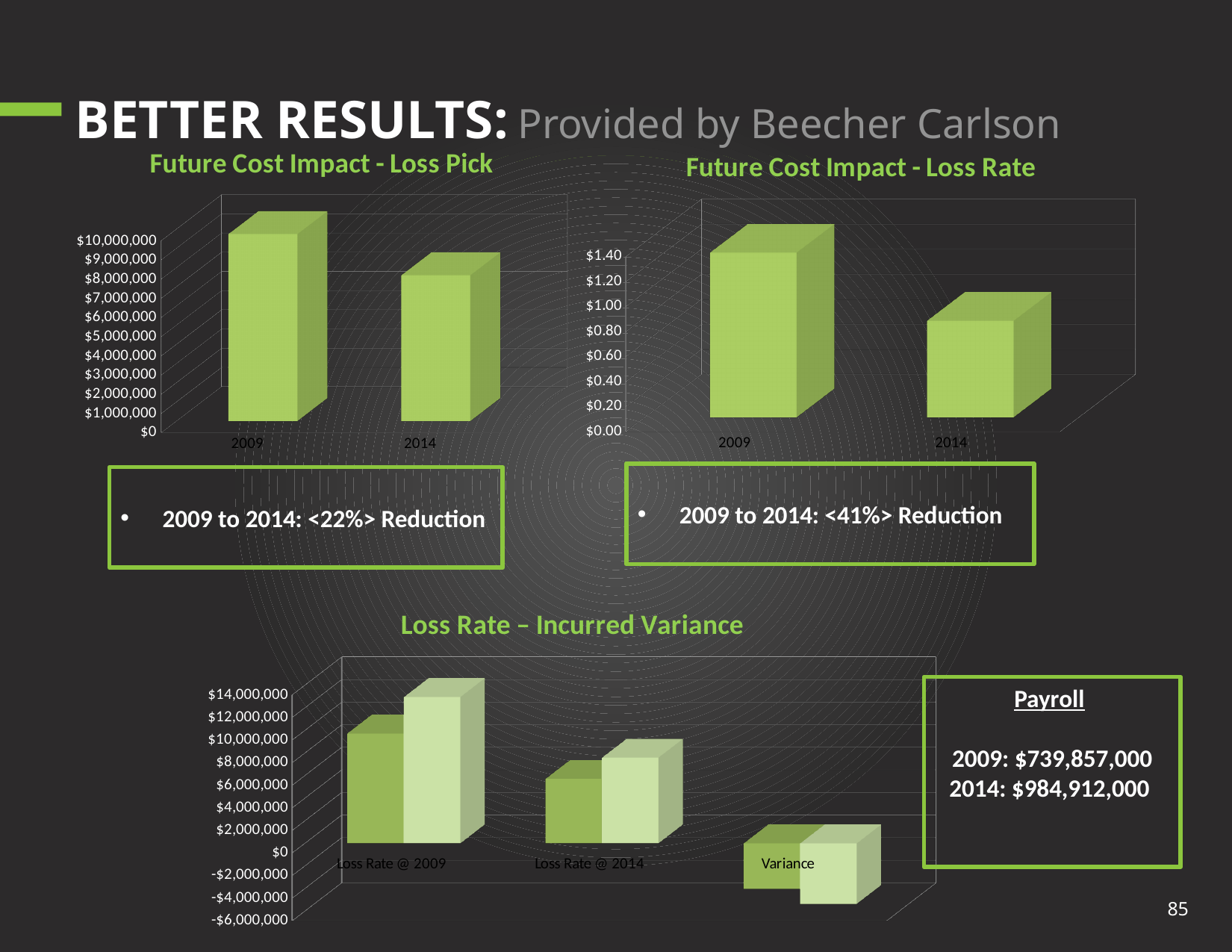
In the 'Future Cost Impact - Loss Rate' chart, is the value for 2014 greater or less than $1.00? less In the 'Future Cost Impact - Loss Pick' chart, is the value for 2014 greater or less than $5,000,000? greater In the 'Future Cost Impact - Loss Pick' chart, is the value for 2009 greater or less than $8,000,000? greater In the 'Future Cost Impact - Loss Rate' chart, which year has the lower value? 2014 In the 'Future Cost Impact - Loss Pick' chart, which year has the higher value? 2009 How many categories are shown on the x axis of the 'Loss Rate – Incurred Variance' chart? 3 In the 'Loss Rate – Incurred Variance' chart, which category has the highest bars, Loss Rate @ 2009 or Loss Rate @ 2014? Loss Rate @ 2009 What kind of chart is the 'Future Cost Impact - Loss Pick' chart? Bar chart In the 'Future Cost Impact - Loss Rate' chart, do the values rise or fall from 2009 to 2014? Fall What is the title of the chart at the bottom of the slide? Loss Rate – Incurred Variance